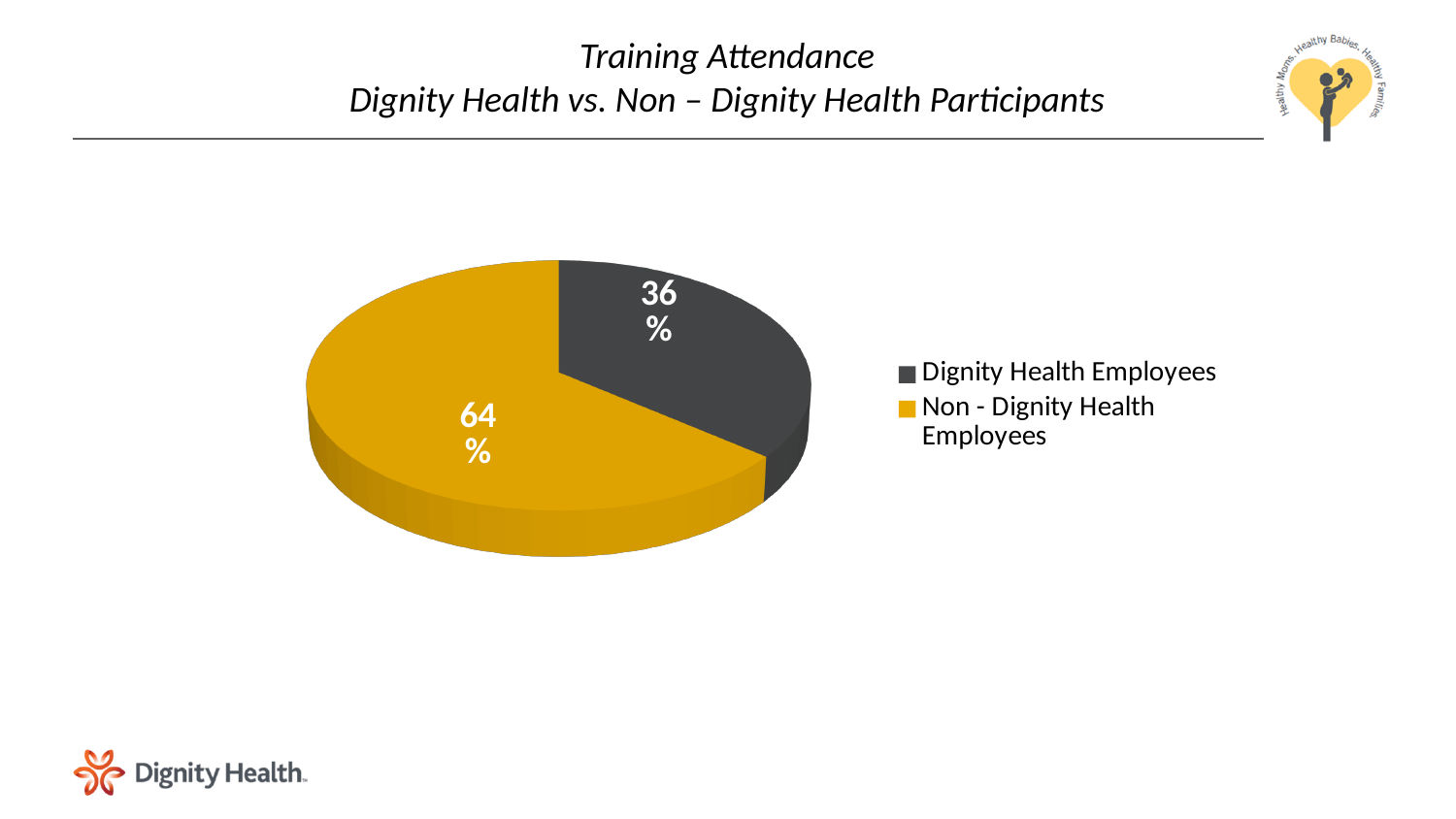
Which is larger, the slice for Dignity Health Employees or the slice for Non - Dignity Health Employees? Non - Dignity Health Employees How many entries does the legend list? 2 What kind of chart is shown on the slide? Pie chart What is the title of the slide? Training Attendance Dignity Health vs. Non – Dignity Health Participants How many slices does the pie chart have? 2 What share of the pie is Non - Dignity Health Employees? 64% What share of the pie is Dignity Health Employees? 36% What is the difference in percentage points between Non - Dignity Health Employees and Dignity Health Employees? 28 What colour is the slice for Non - Dignity Health Employees? Yellow Which category has the largest slice of the pie? Non - Dignity Health Employees Which category has the smallest slice of the pie? Dignity Health Employees